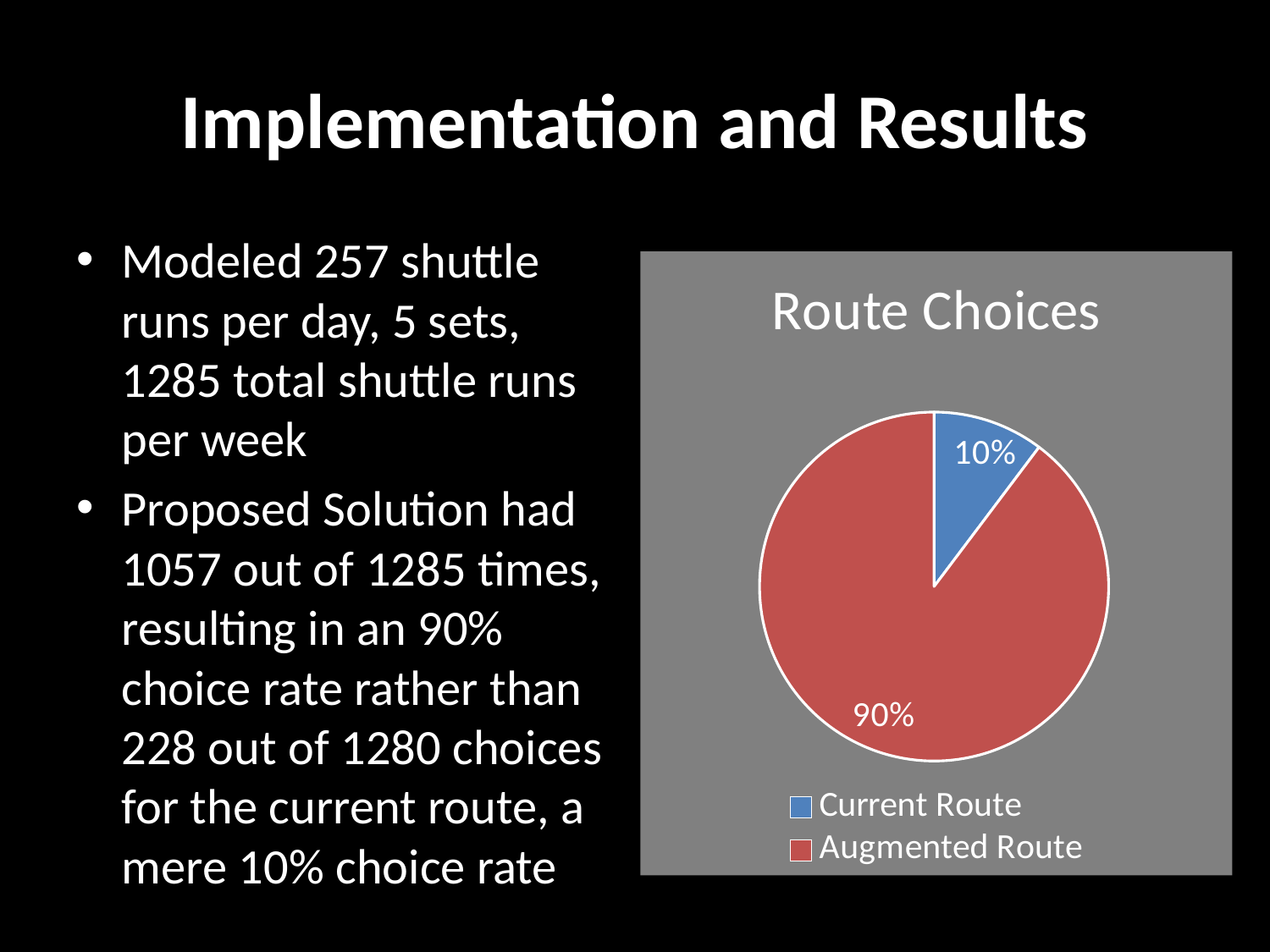
Is the share for Augmented Route greater or less than 50%? greater Which slice of the pie is the largest? Augmented Route What share of the pie does Current Route have? 10% What kind of chart is shown on the slide? pie chart What share of the pie does Augmented Route have? 90% What colour is the Current Route slice? blue How many entries does the legend list? 2 What is the difference in percentage points between the Augmented Route and Current Route slices? 80 How many slices does the pie chart have? 2 Which slice of the pie is the smallest? Current Route Which is larger, the Current Route slice or the Augmented Route slice? Augmented Route What is the title of the chart? Route Choices